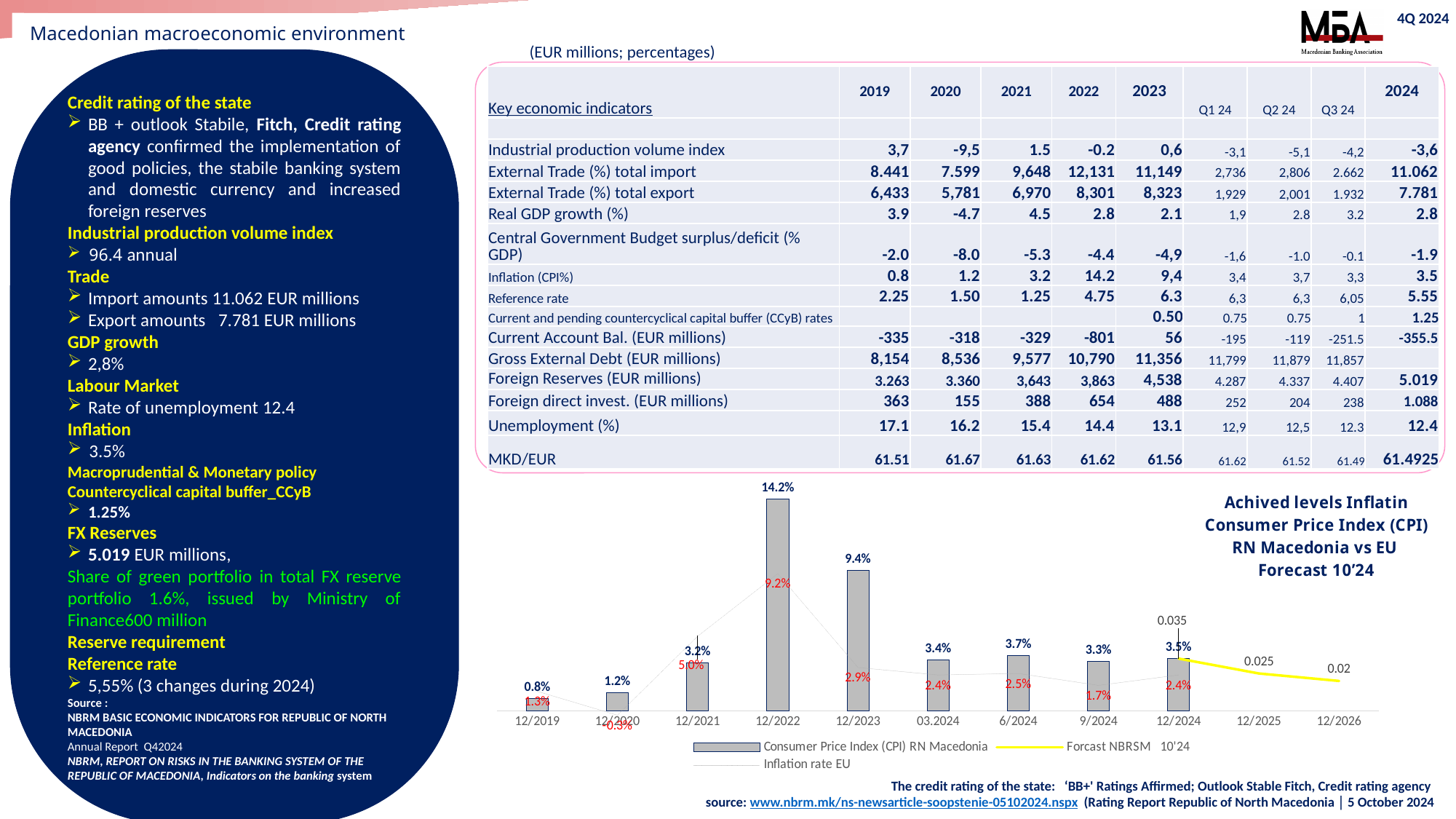
How many series does the chart legend list? 3 What kind of chart is used to show the Consumer Price Index (CPI) RN Macedonia? Bar chart Which is larger in the chart: the CPI RN Macedonia value for 6/2024 or for 9/2024? 6/2024 What is the Consumer Price Index (CPI) RN Macedonia value for 12/2023 in the chart? 9.4% Does the Forcast NBRSM 10'24 line rise or fall from 12/2024 to 12/2026? Fall Which period has the highest Consumer Price Index (CPI) RN Macedonia value in the chart? 12/2022 What is the Forcast NBRSM 10'24 value shown for 12/2026 in the chart? 0.02 What is the Inflation rate EU value for 12/2022 in the chart? 9.2% What is the difference between the CPI RN Macedonia values for 12/2022 and 12/2023? 4.8% Which period has the lowest Consumer Price Index (CPI) RN Macedonia value in the chart? 12/2019 How many periods are shown on the x axis of the chart? 11 What is the Consumer Price Index (CPI) RN Macedonia value for 12/2022 in the chart? 14.2%